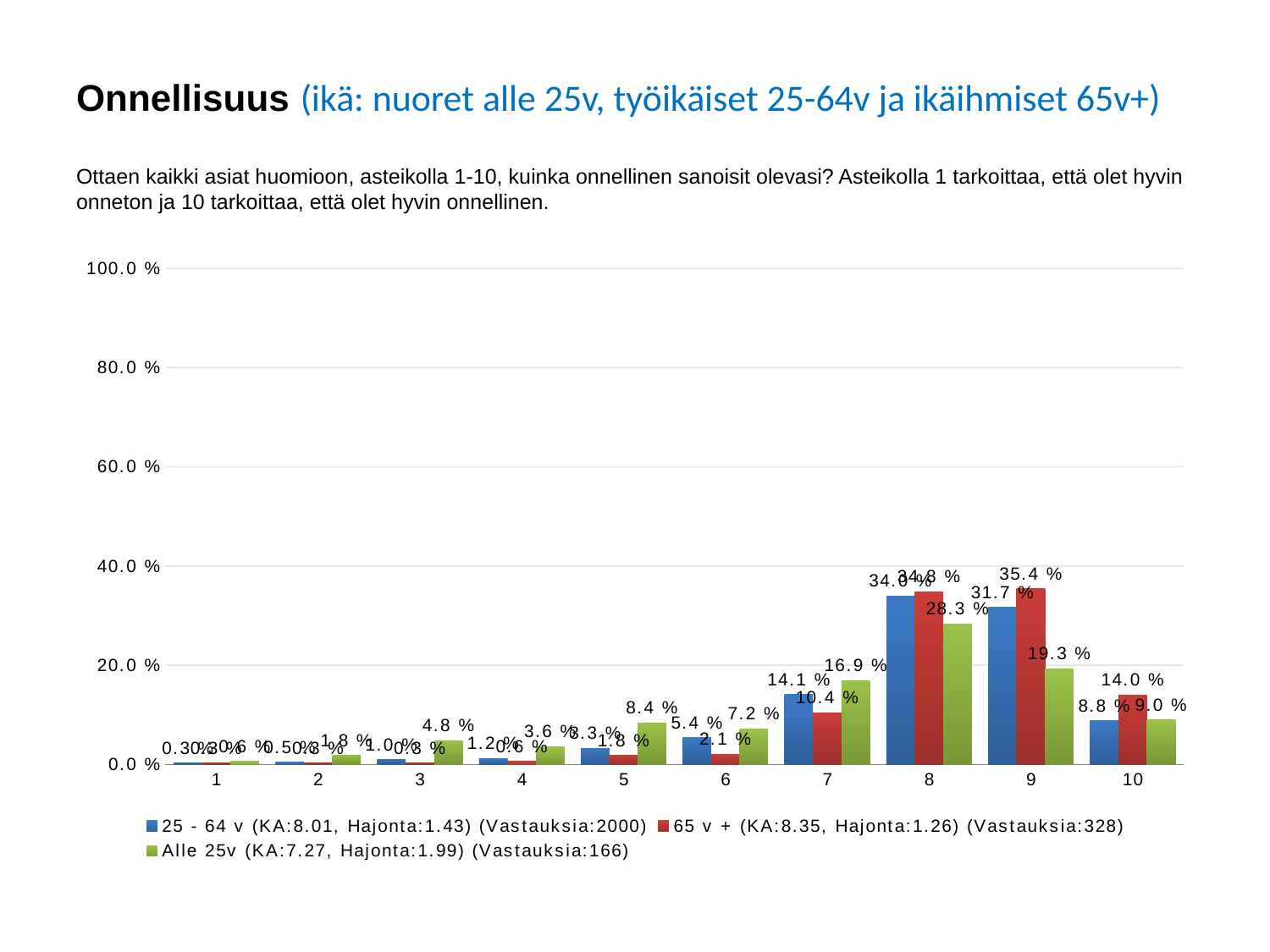
What kind of chart is shown on the slide? bar chart What is the value for the 25 - 64 v series at category 7? 14.1 % What is the difference between the Alle 25v and 25 - 64 v values at category 7? 2.8 % What is the value for the 65 v + series at category 10? 14.0 % What is the value for the 65 v + series at category 9? 35.4 % How many series does the legend list? 3 At category 10, which is larger: the 65 v + value or the Alle 25v value? 65 v + Is the value for the 25 - 64 v series at category 9 greater or less than 20.0 %? greater How many categories are shown on the x axis? 10 What is the value for the Alle 25v series at category 8? 28.3 % Which series has the highest value at category 9? 65 v + Which series has the lowest value at category 7? 65 v +